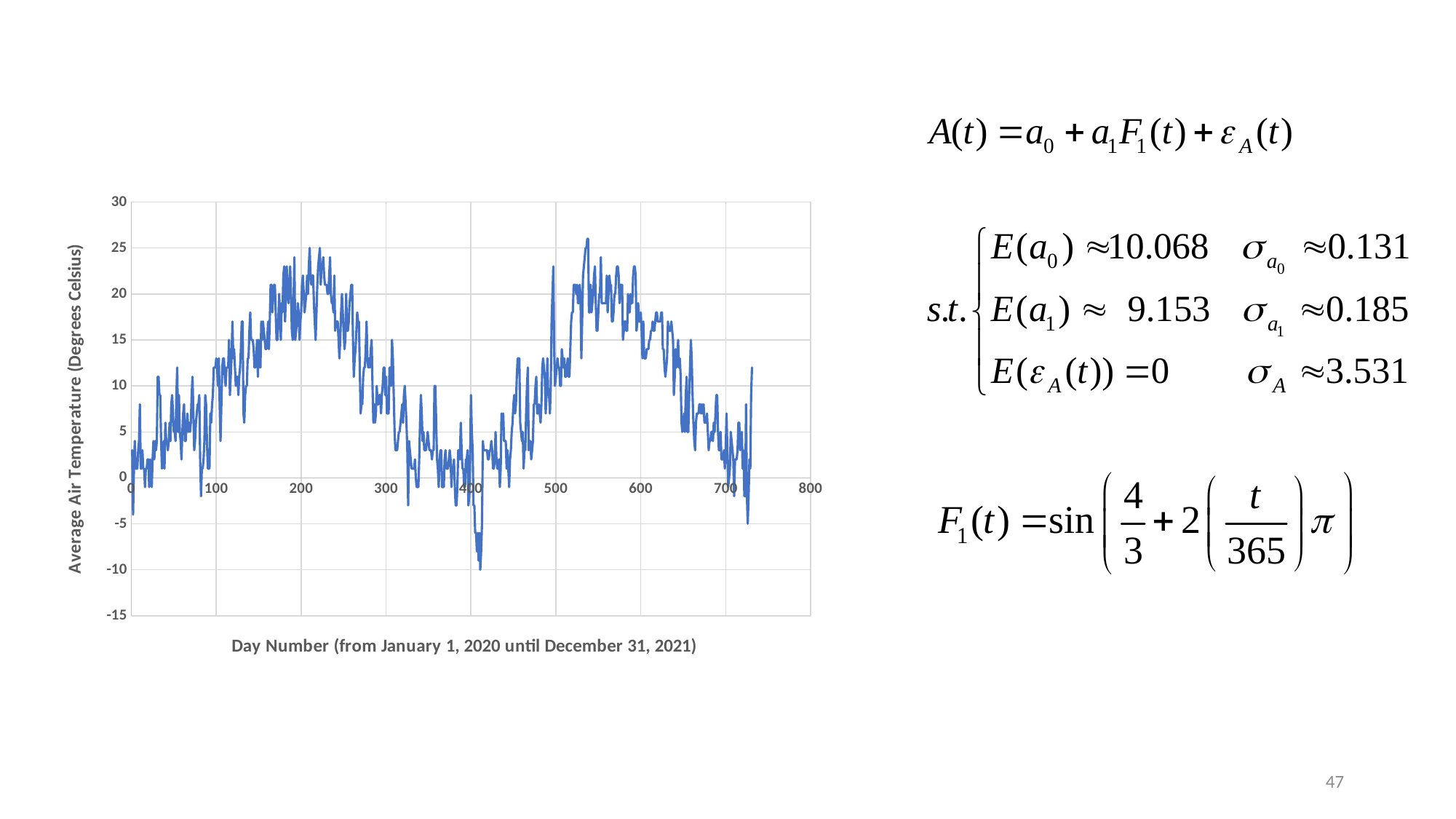
Do the values generally rise or fall between day 550 and day 700? fall Is the lowest value of the line, near day 410, greater or less than -5? less Is the value of the line around day 650 greater or less than 0? greater What is the label of the horizontal axis of the chart? Day Number (from January 1, 2020 until December 31, 2021) Is the highest value of the line, near day 540, greater or less than 20? greater Do the values generally rise or fall between day 0 and day 200? rise What kind of chart is shown on the slide? line chart What is the label of the vertical axis of the chart? Average Air Temperature (Degrees Celsius) What is the highest tick value shown on the vertical axis? 30 Do the values generally rise or fall between day 220 and day 400? fall